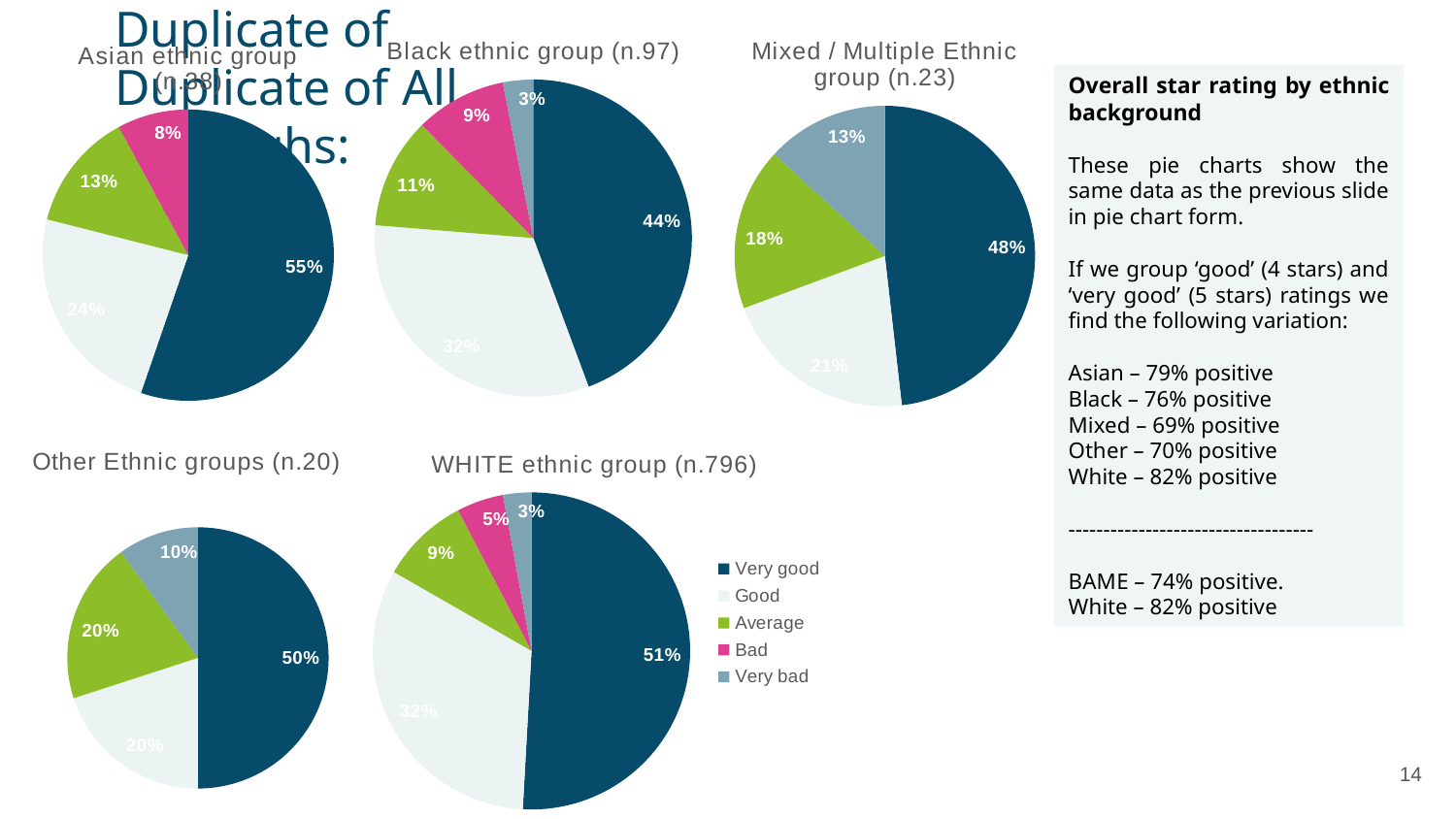
In the WHITE ethnic group (n.796) pie chart, what percentage is shown for the Average slice? 9% In the Mixed / Multiple Ethnic group (n.23) pie chart, what percentage is shown for the Very bad slice? 13% How many categories does the legend list? 5 In the WHITE ethnic group (n.796) pie chart, which category has the smallest slice? Very bad How many slices does the Other Ethnic groups (n.20) pie chart have? 4 In the Asian ethnic group pie chart, which category has the largest slice? Very good In the Black ethnic group (n.97) pie chart, what percentage is labelled for the Very good slice? 44% What share of the Mixed / Multiple Ethnic group (n.23) pie chart is labelled Average? 18% Is the Very good slice larger in the Asian ethnic group pie chart or in the Mixed / Multiple Ethnic group (n.23) pie chart? Asian ethnic group In the Black ethnic group (n.97) pie chart, what is the difference between the Very good and Good percentages? 12% What type of chart is used for the WHITE ethnic group (n.796) data? Pie chart In the Other Ethnic groups (n.20) pie chart, what percentage is shown for the Very good slice? 50%